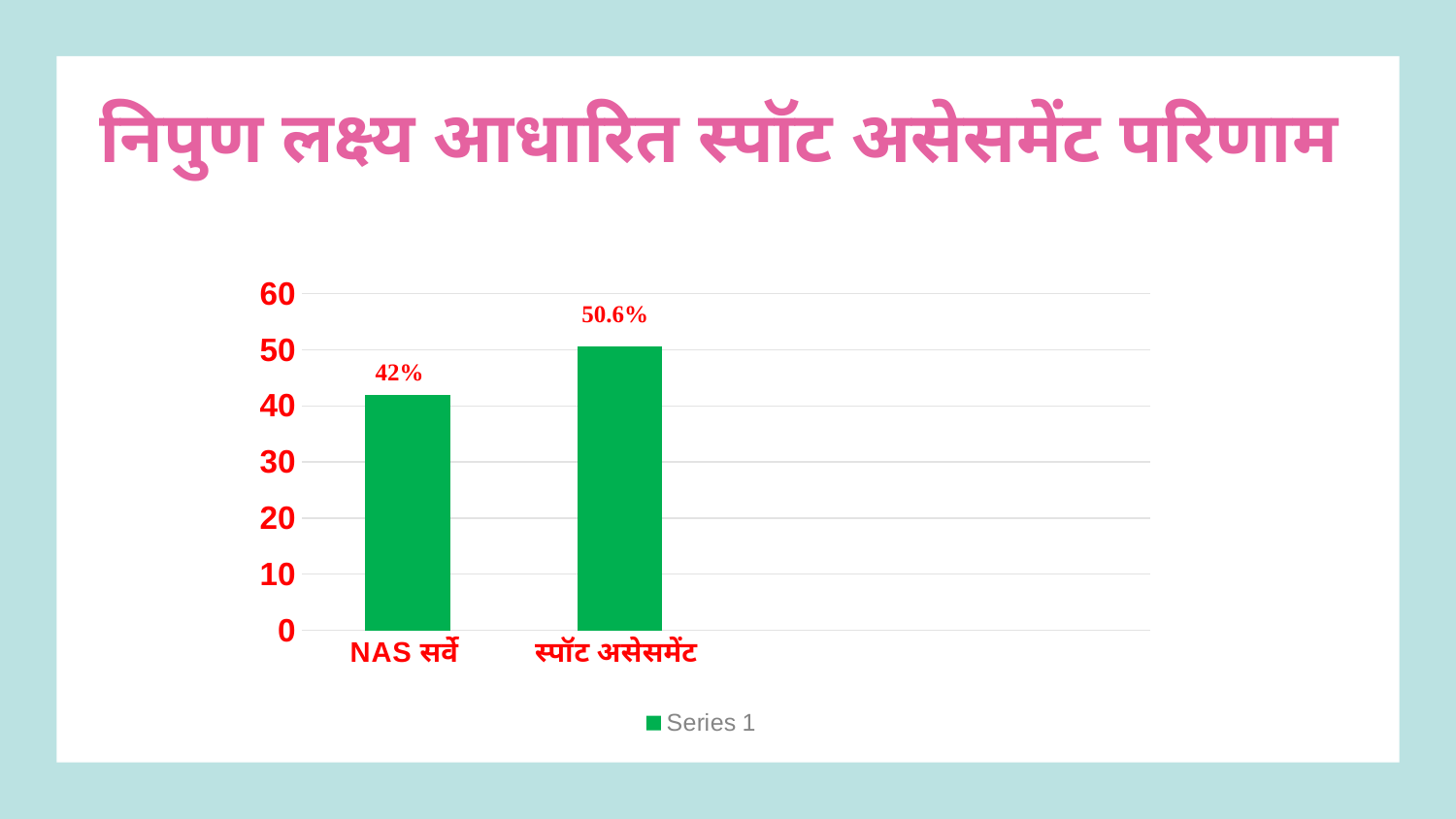
Which category has the lowest value? NAS सर्वे What kind of chart is shown on the slide? bar chart Is the value for NAS सर्वे greater or less than 50? less What is the legend entry shown below the chart? Series 1 What is the value for स्पॉट असेसमेंट? 50.6% What is the value for NAS सर्वे? 42% Which category has the highest value? स्पॉट असेसमेंट Is the value for स्पॉट असेसमेंट greater or less than 40? greater How many series does the legend list? 1 Which is larger, the value for NAS सर्वे or the value for स्पॉट असेसमेंट? स्पॉट असेसमेंट How many categories are shown on the x axis? 2 What is the difference between the values for स्पॉट असेसमेंट and NAS सर्वे? 8.6%